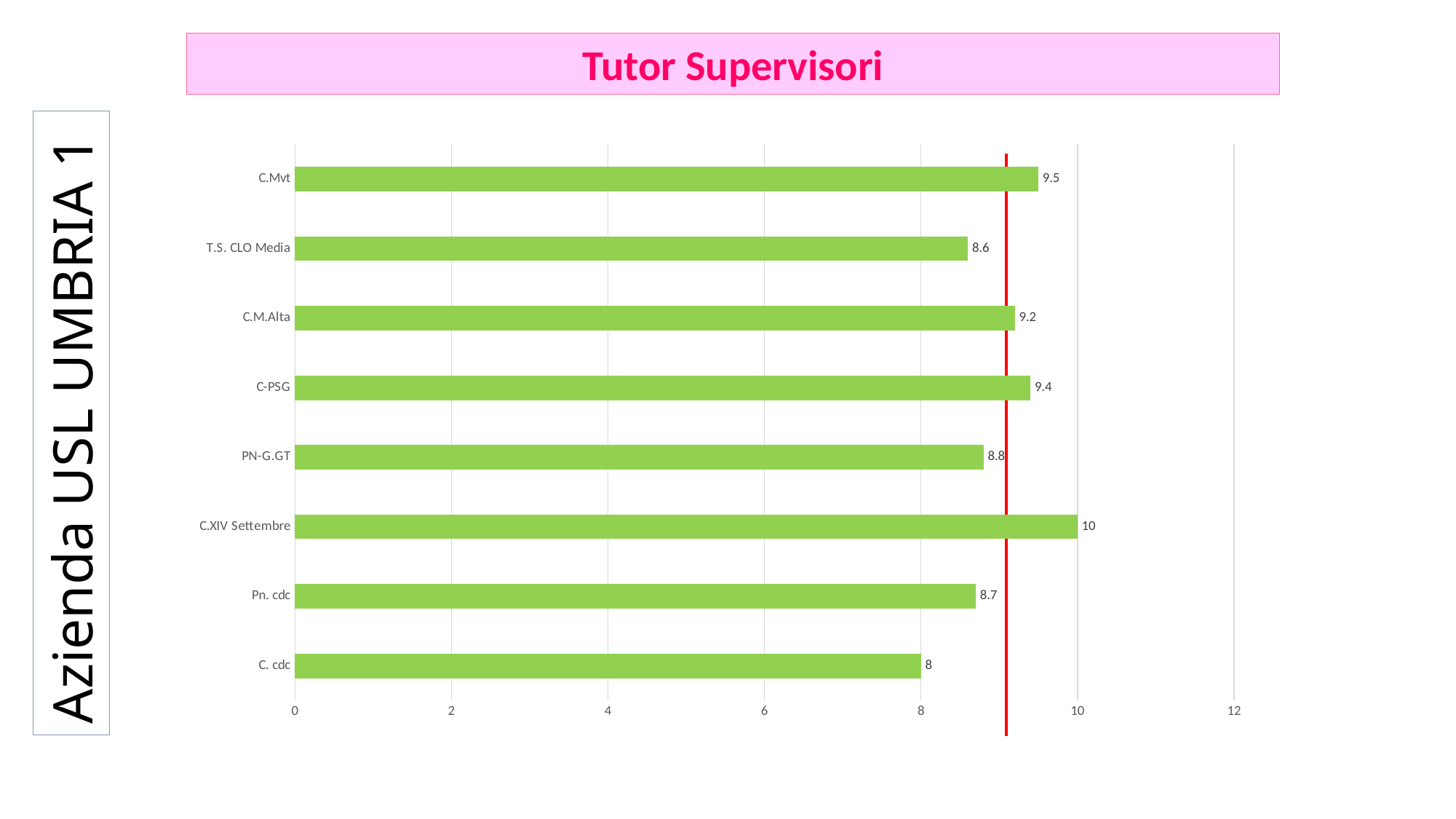
Which is larger, the value for C.M.Alta or the value for Pn. cdc? C.M.Alta What is the value for C.XIV Settembre? 10 What kind of chart is shown on the slide? Bar chart What is the title of the chart? Tutor Supervisori What is the value for C.Mvt? 9.5 What is the value for T.S. CLO Media? 8.6 Which category has the lowest value? C. cdc How many categories are shown in the chart? 8 What is the difference between the values for C.XIV Settembre and C. cdc? 2 What is the value for C. cdc? 8 Which category has the highest value? C.XIV Settembre What is the difference between the values for C-PSG and PN-G.GT? 0.6